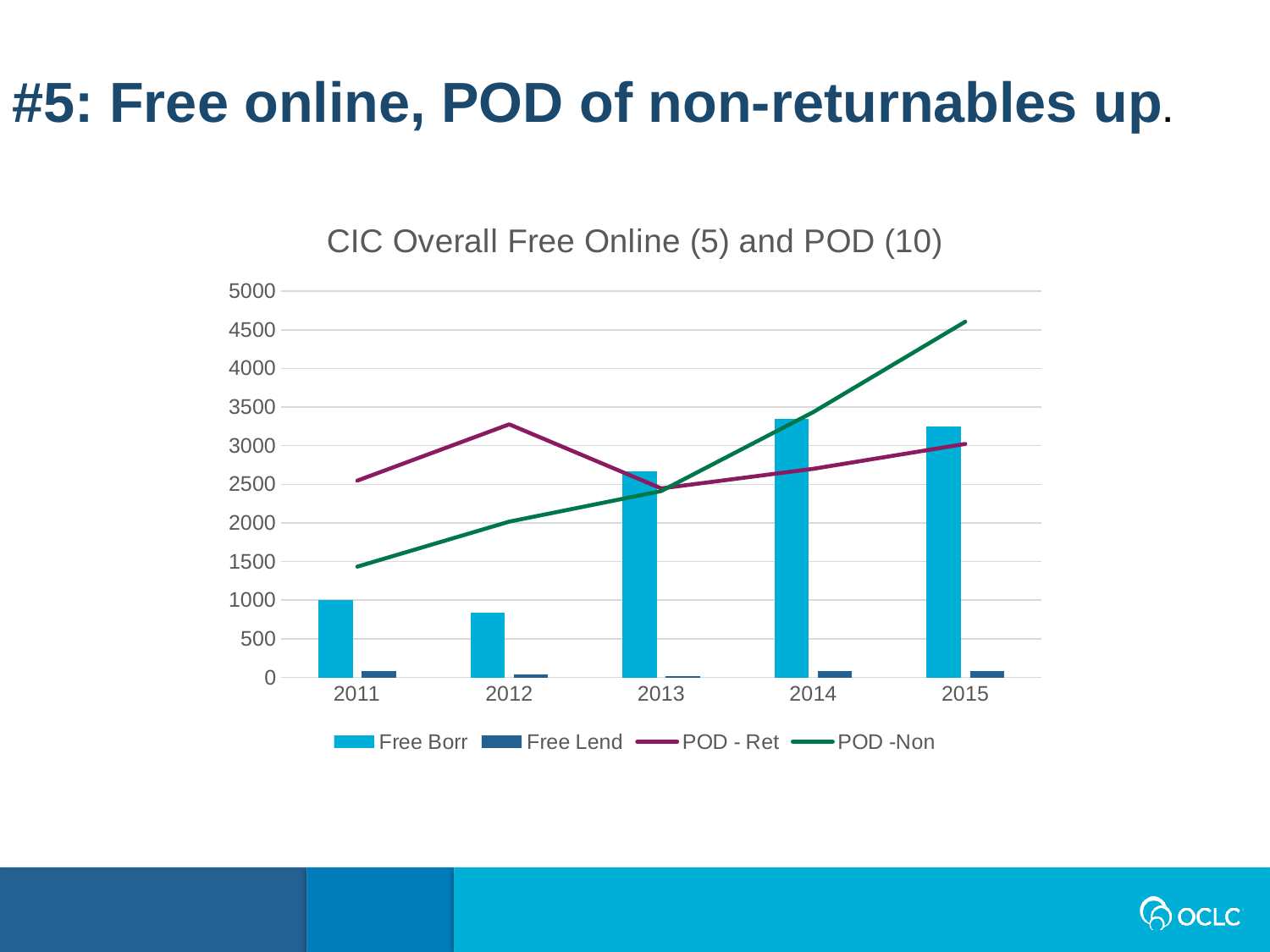
In 2015, which is larger, POD -Non or POD - Ret? POD -Non What kind of chart is shown on the slide? A combination bar and line chart How many series does the legend list? 4 Does the POD -Non line rise or fall from 2011 to 2015? Rises Is the Free Lend value for 2013 greater or less than 500? less What is the title of the chart? CIC Overall Free Online (5) and POD (10) Is the Free Borr value for 2013 greater or less than 2500? greater In which year is the POD - Ret line at its highest? 2012 How many years are shown on the x axis? 5 Is the POD -Non value for 2015 greater or less than 4500? greater In which year is the Free Borr bar the lowest? 2012 In which year is the POD -Non line at its highest? 2015